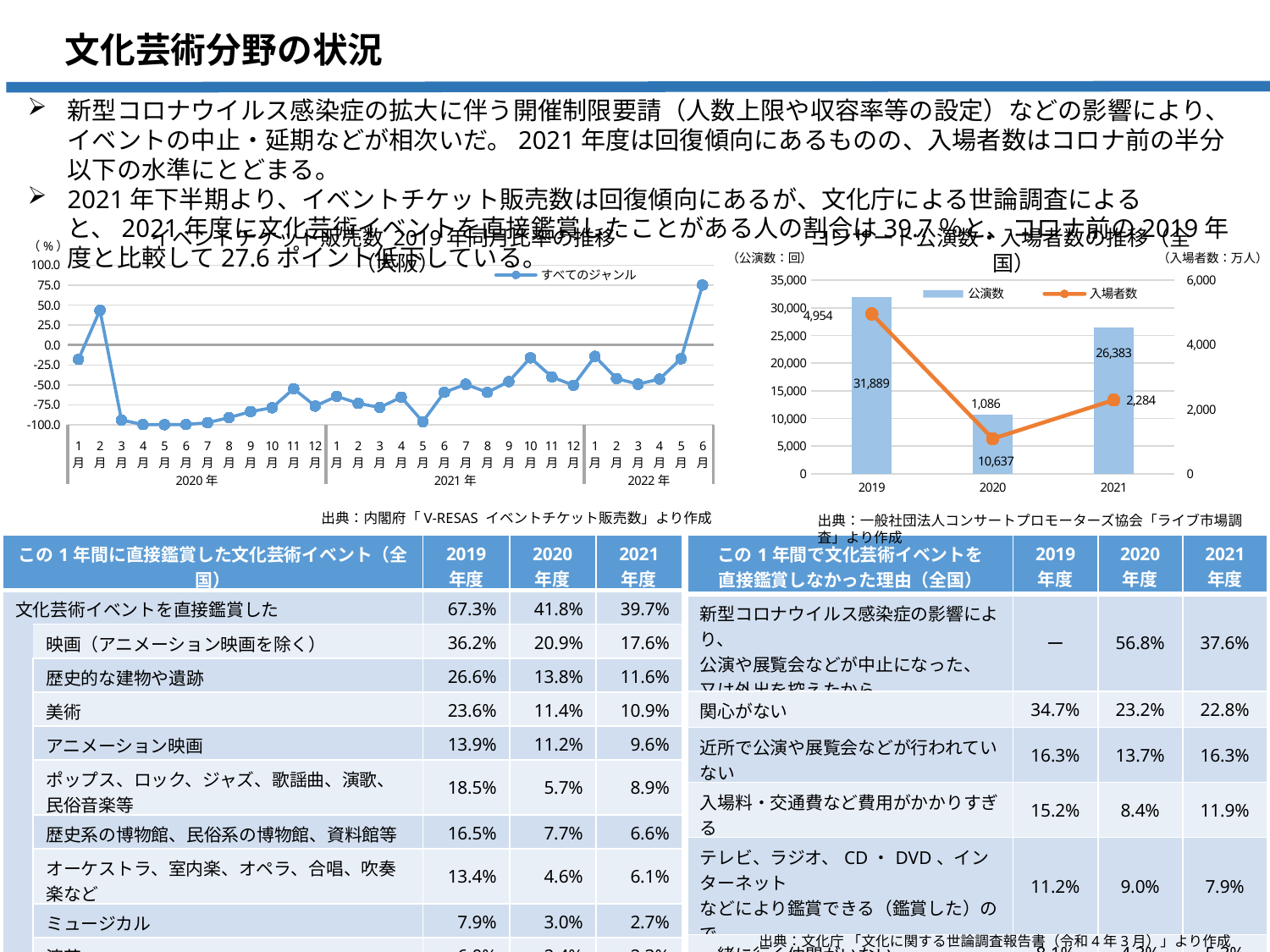
In the right-hand chart (コンサート公演数・入場者数の推移), is the 入場者数 larger in 2019 or in 2021? 2019 In the right-hand chart (コンサート公演数・入場者数の推移), which year has the lowest 公演数? 2020 How many series does the legend of the right-hand chart (コンサート公演数・入場者数の推移) list? 2 In the right-hand chart (コンサート公演数・入場者数の推移), which year has the highest 入場者数? 2019 In the right-hand chart (コンサート公演数・入場者数の推移), what is the difference in 公演数 between 2019 and 2020? 21,252 In the right-hand chart (コンサート公演数・入場者数の推移), what is the 公演数 value for 2021? 26,383 In the left-hand line chart (イベントチケット販売数 2019年同月比率の推移), is the value for 2022年6月 greater or less than 50.0? greater In the right-hand chart (コンサート公演数・入場者数の推移), what is the 入場者数 value for 2020? 1,086 In the left-hand line chart (イベントチケット販売数 2019年同月比率の推移), is the value for 2020年3月 greater or less than -75.0? less What type of chart is the left-hand chart showing イベントチケット販売数 2019年同月比率の推移? Line chart In the right-hand chart (コンサート公演数・入場者数の推移), what is the 公演数 value for 2019? 31,889 In the right-hand chart (コンサート公演数・入場者数の推移), what is the difference in 入場者数 between 2021 and 2020? 1,198